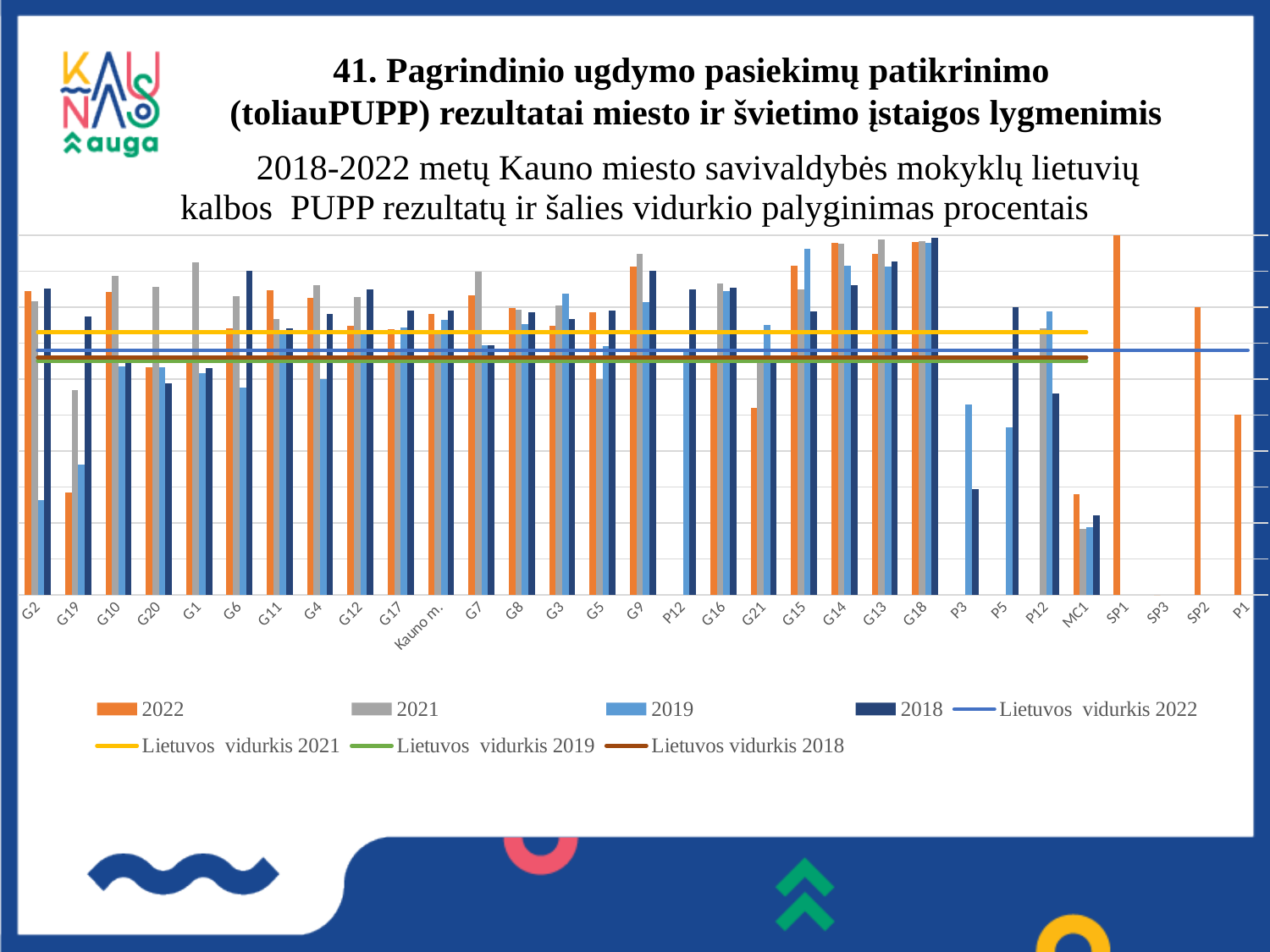
For G2, which is larger: the 2022 bar or the 2019 bar? 2022 For MC1, which is larger: the 2022 bar or the 2021 bar? 2022 For P3, which is larger: the 2019 bar or the 2018 bar? 2019 What colour are the 2022 bars in the chart? orange How many series does the chart legend list? 8 How many categories are shown along the x axis of the chart? 31 Which category has the lowest 2021 bar? MC1 What kind of chart is shown on the slide? bar chart Which legend entry is shown as a yellow line? Lietuvos vidurkis 2021 Which category has the tallest 2022 bar? SP1